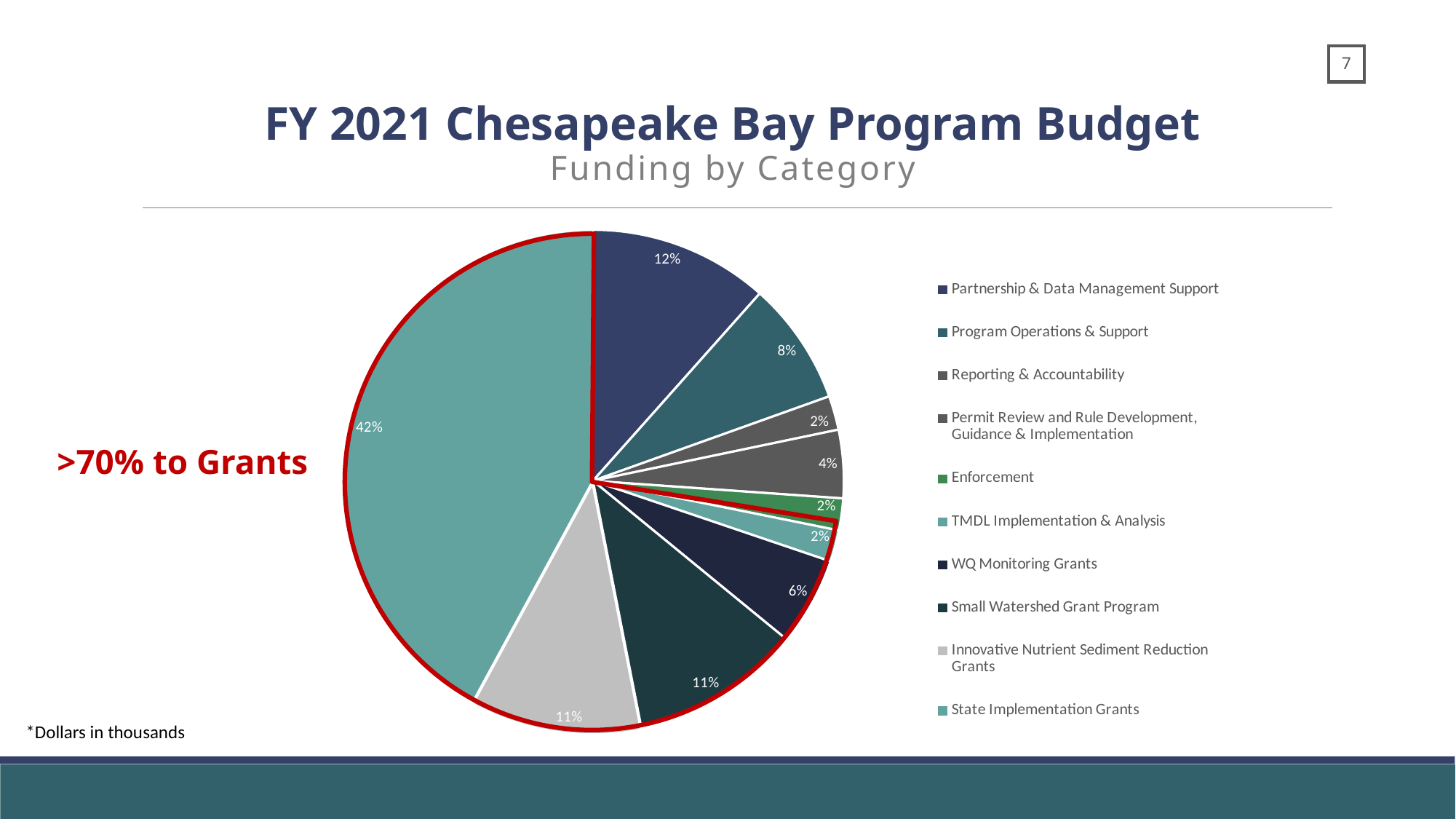
Which receives a larger share of the budget: Partnership & Data Management Support or Program Operations & Support? Partnership & Data Management Support What does the red text to the left of the pie chart say? >70% to Grants Which category receives the largest share of the FY 2021 budget? State Implementation Grants What share of the budget goes to Permit Review and Rule Development, Guidance & Implementation? 4% What percentage of the budget is allocated to Partnership & Data Management Support? 12% What share of funding goes to Program Operations & Support? 8% What is the combined share of Small Watershed Grant Program and Innovative Nutrient Sediment Reduction Grants? 22% How many categories does the legend list? 10 How many percentage points larger is the State Implementation Grants share than the Partnership & Data Management Support share? 30 percentage points What share of the FY 2021 Chesapeake Bay Program budget goes to State Implementation Grants? 42% What type of chart is used to show funding by category? Pie chart What percentage of the budget is for WQ Monitoring Grants? 6%